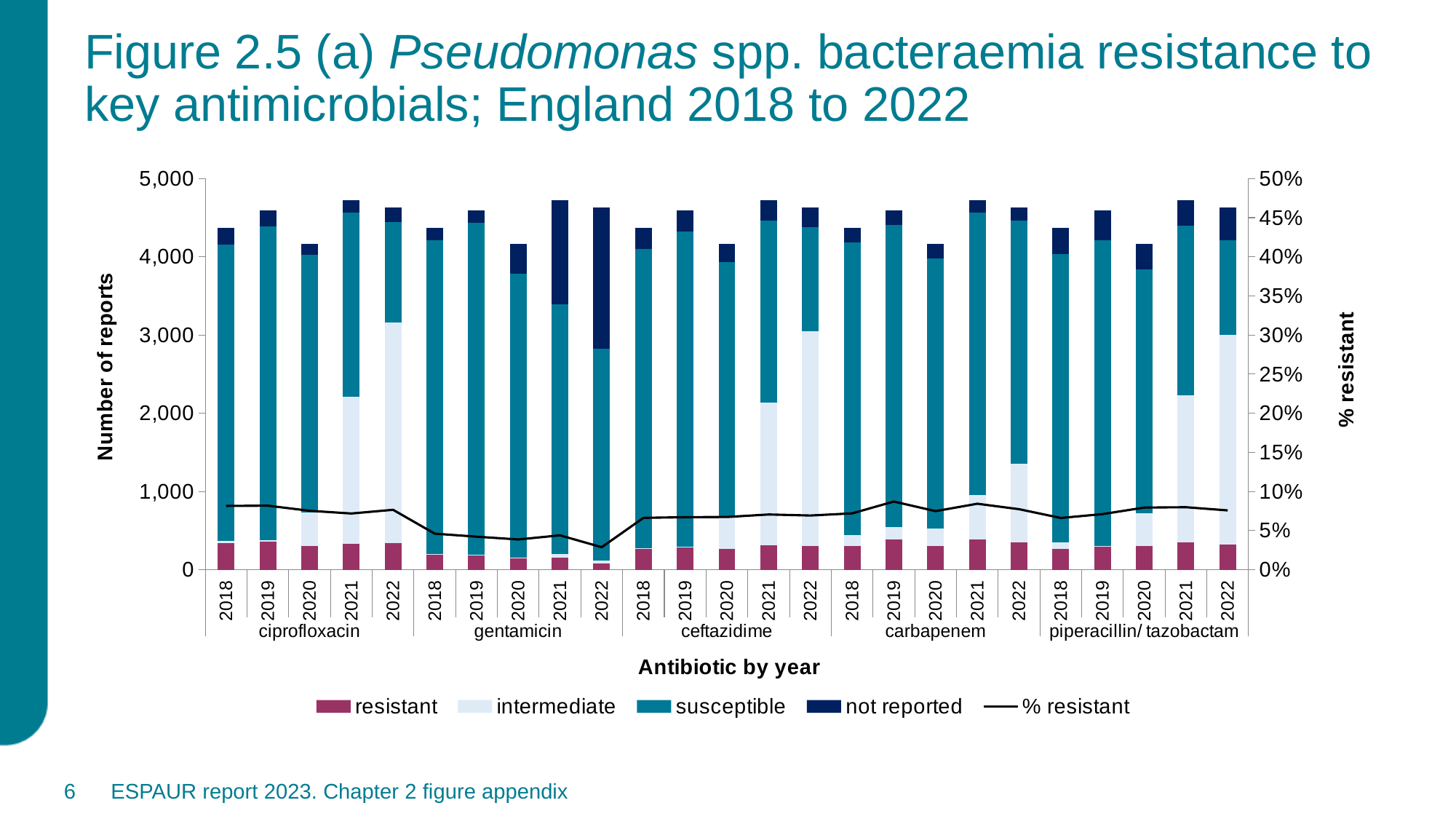
Does the % resistant line for gentamicin rise or fall from 2018 to 2022? fall What kind of chart is shown on the slide? bar chart (stacked bars with a line) How many antibiotic groups are shown along the x axis? 5 How many bars are plotted in total on the chart? 25 Is the % resistant value for carbapenem in 2019 greater or less than 5%? greater Is the % resistant value for gentamicin in 2022 greater or less than 5%? less Within ciprofloxacin, which year has the largest intermediate segment? 2022 Which antibiotic group has the lowest % resistant line across all years? gentamicin What is the title of the left vertical axis? Number of reports How many series does the legend list? 5 Is the total number of reports for piperacillin/tazobactam in 2020 greater or less than 4,500? less